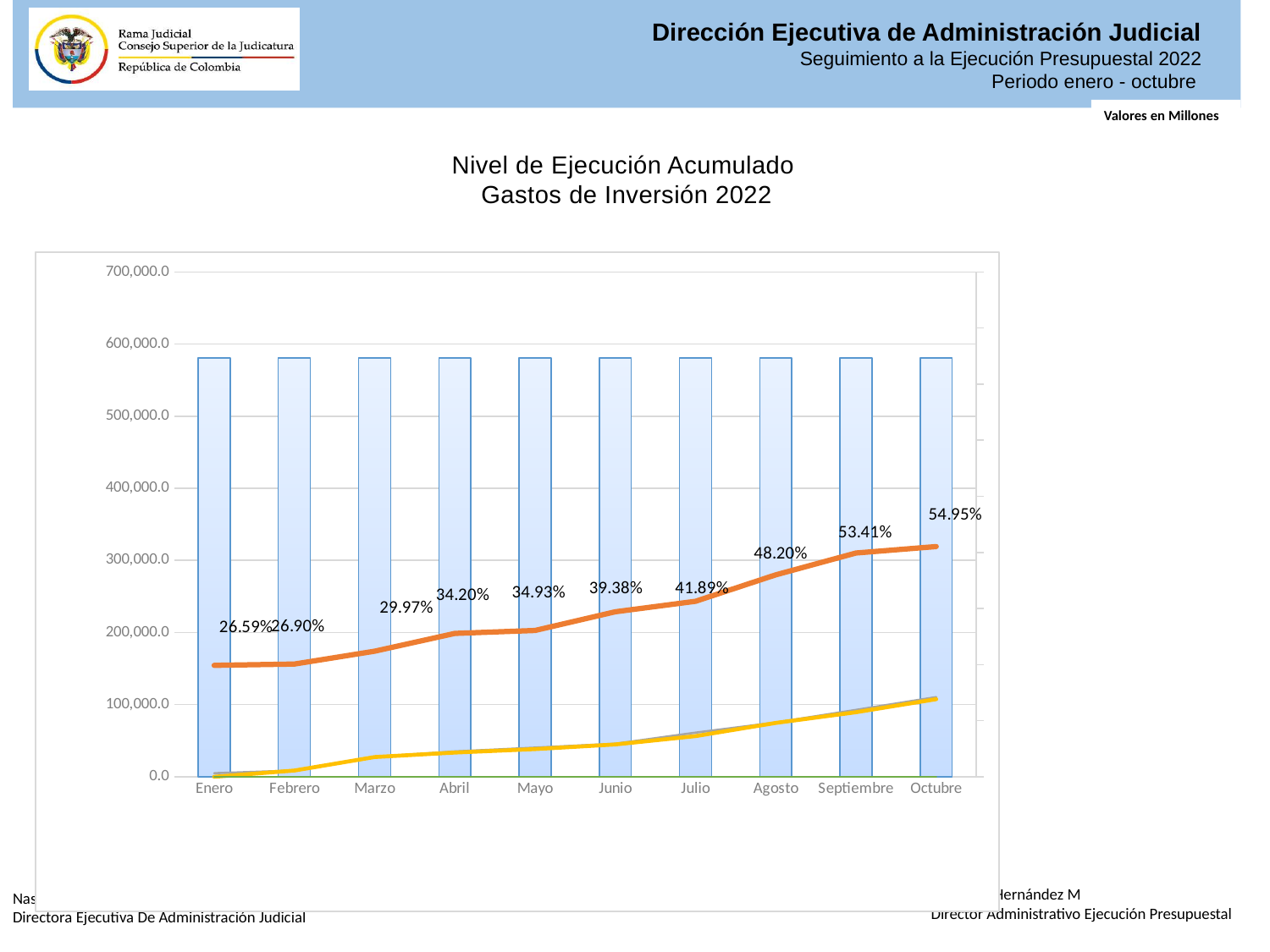
Which has a larger percentage label, Abril or Mayo? Mayo What percentage label is shown for Junio on the chart? 39.38% What is the difference between the percentage labels for Octubre and Septiembre? 1.54% What percentage label is shown for Octubre on the chart? 54.95% What is the title of the chart? Nivel de Ejecución Acumulado Gastos de Inversión 2022 How many months are shown on the x axis of the chart? 10 Which month has the highest percentage label on the chart? Octubre Is the value of the bar for Enero greater or less than 500,000.0? greater What percentage label is shown for Agosto on the chart? 48.20% Which month has the lowest percentage label on the chart? Enero What percentage label is shown for Enero on the chart? 26.59% Do the percentage labels rise or fall from Enero to Octubre? rise